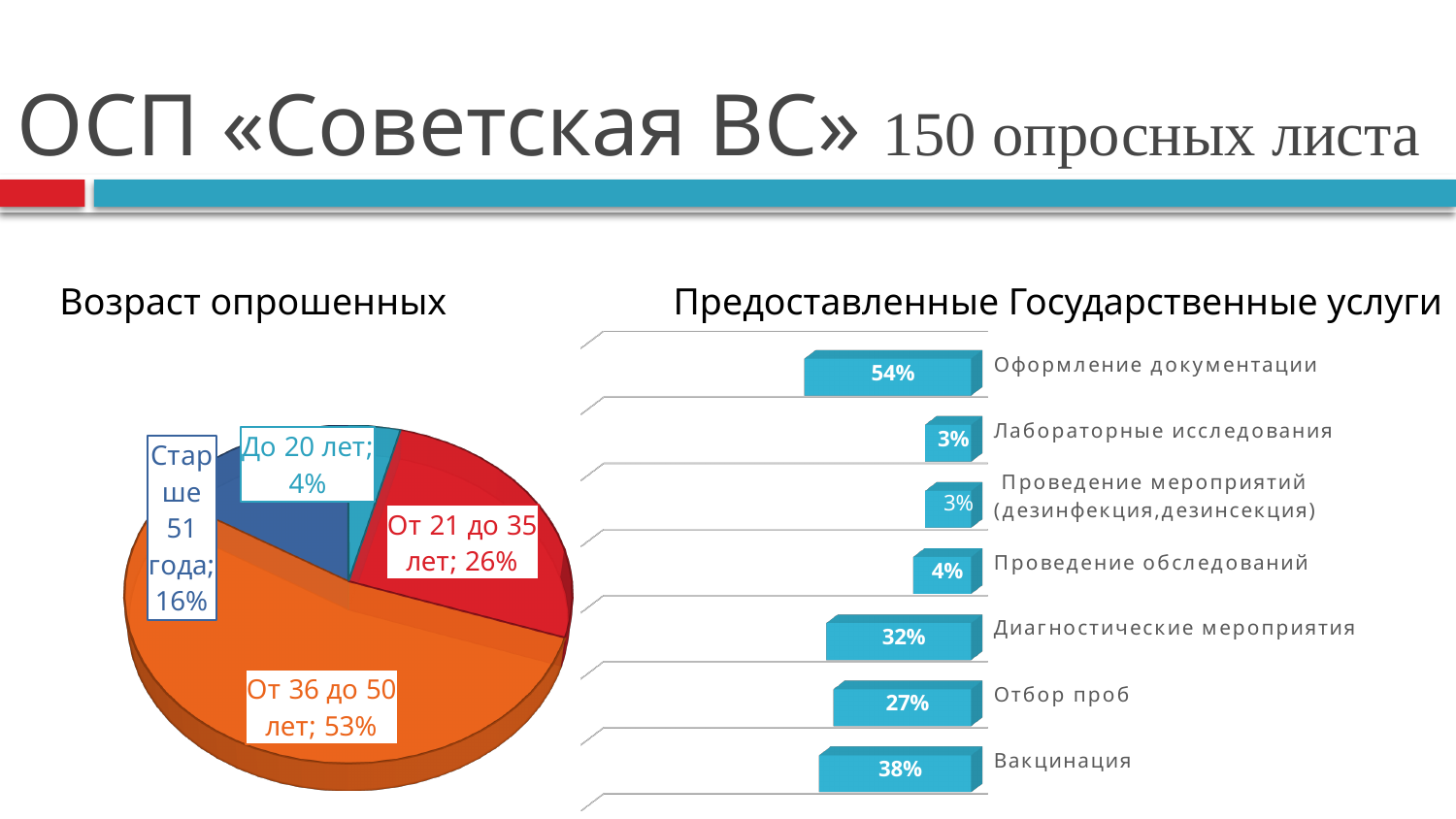
In the 'Возраст опрошенных' chart, which age group has the largest share? От 36 до 50 лет What kind of chart is 'Возраст опрошенных'? Pie chart In the 'Предоставленные Государственные услуги' chart, how many services are listed? 7 In the 'Возраст опрошенных' chart, what share of respondents are 'От 36 до 50 лет'? 53% In the 'Предоставленные Государственные услуги' chart, which is larger: 'Диагностические мероприятия' or 'Отбор проб'? Диагностические мероприятия In the 'Возраст опрошенных' chart, what is the difference between the shares of 'От 21 до 35 лет' and 'Старше 51 года'? 10% What kind of chart is 'Предоставленные Государственные услуги'? Bar chart In the 'Возраст опрошенных' chart, which age group has the smallest share? До 20 лет In the 'Предоставленные Государственные услуги' chart, which service has the highest value? Оформление документации In the 'Возраст опрошенных' chart, how many age groups are shown? 4 In the 'Предоставленные Государственные услуги' chart, what is the value for 'Вакцинация'? 38% In the 'Возраст опрошенных' chart, what share of respondents are 'До 20 лет'? 4%